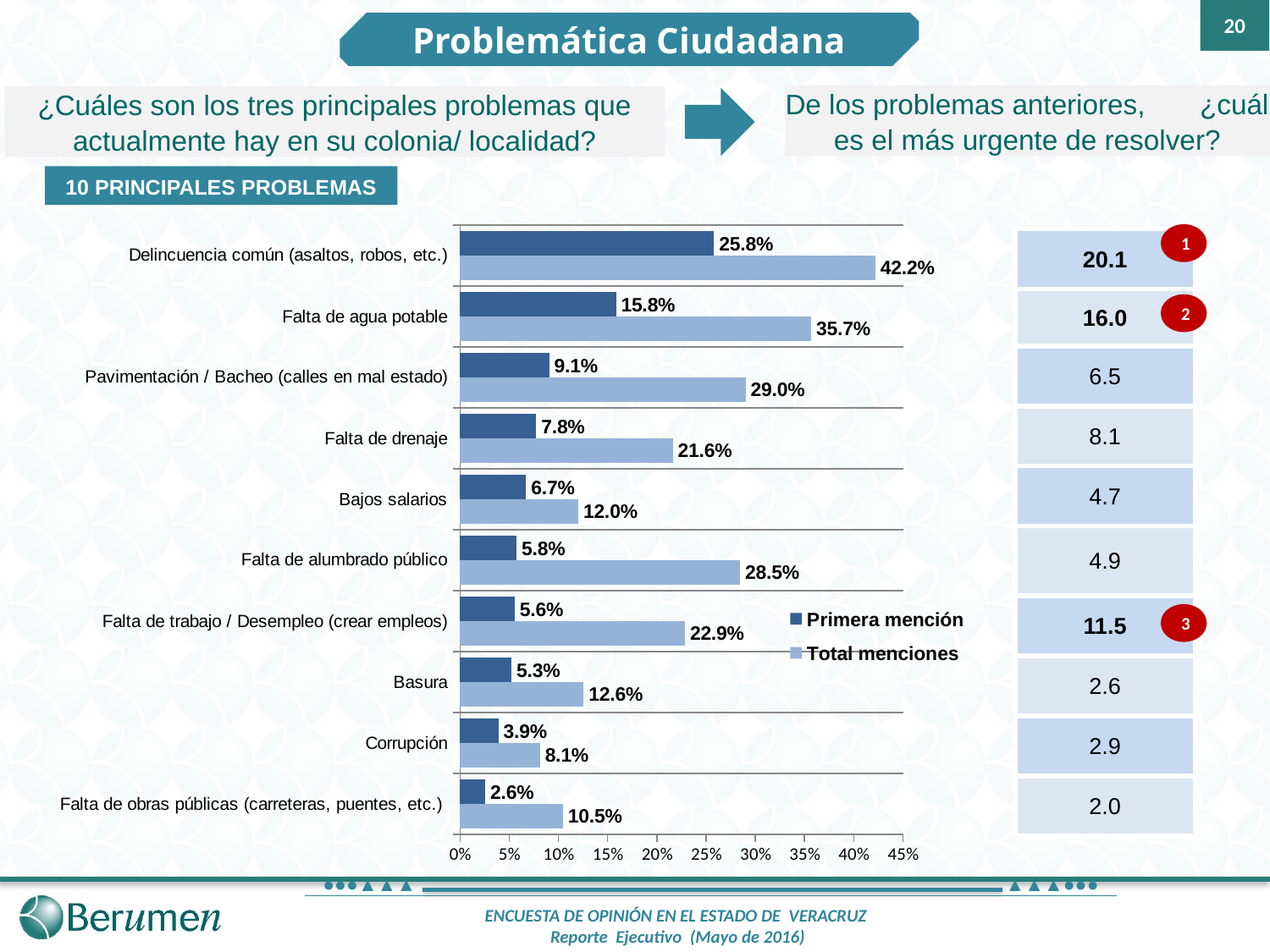
What are the two series named in the chart legend? Primera mención and Total menciones What is the Primera mención value for Falta de agua potable? 15.8% What kind of chart is shown on the slide? bar chart Which is larger: the Total menciones value for Pavimentación / Bacheo (calles en mal estado) or for Falta de trabajo / Desempleo (crear empleos)? Pavimentación / Bacheo (calles en mal estado) Is the Total menciones value for Basura greater or less than 15%? less How many series does the chart legend list? 2 How many categories are shown in the bar chart? 10 What is the Total menciones value for Falta de alumbrado público? 28.5% What is the Total menciones value for Delincuencia común (asaltos, robos, etc.)? 42.2% Which category has the lowest Total menciones value? Corrupción Which category has the highest Primera mención value? Delincuencia común (asaltos, robos, etc.) What is the difference between the Total menciones and Primera mención values for Falta de drenaje? 13.8%